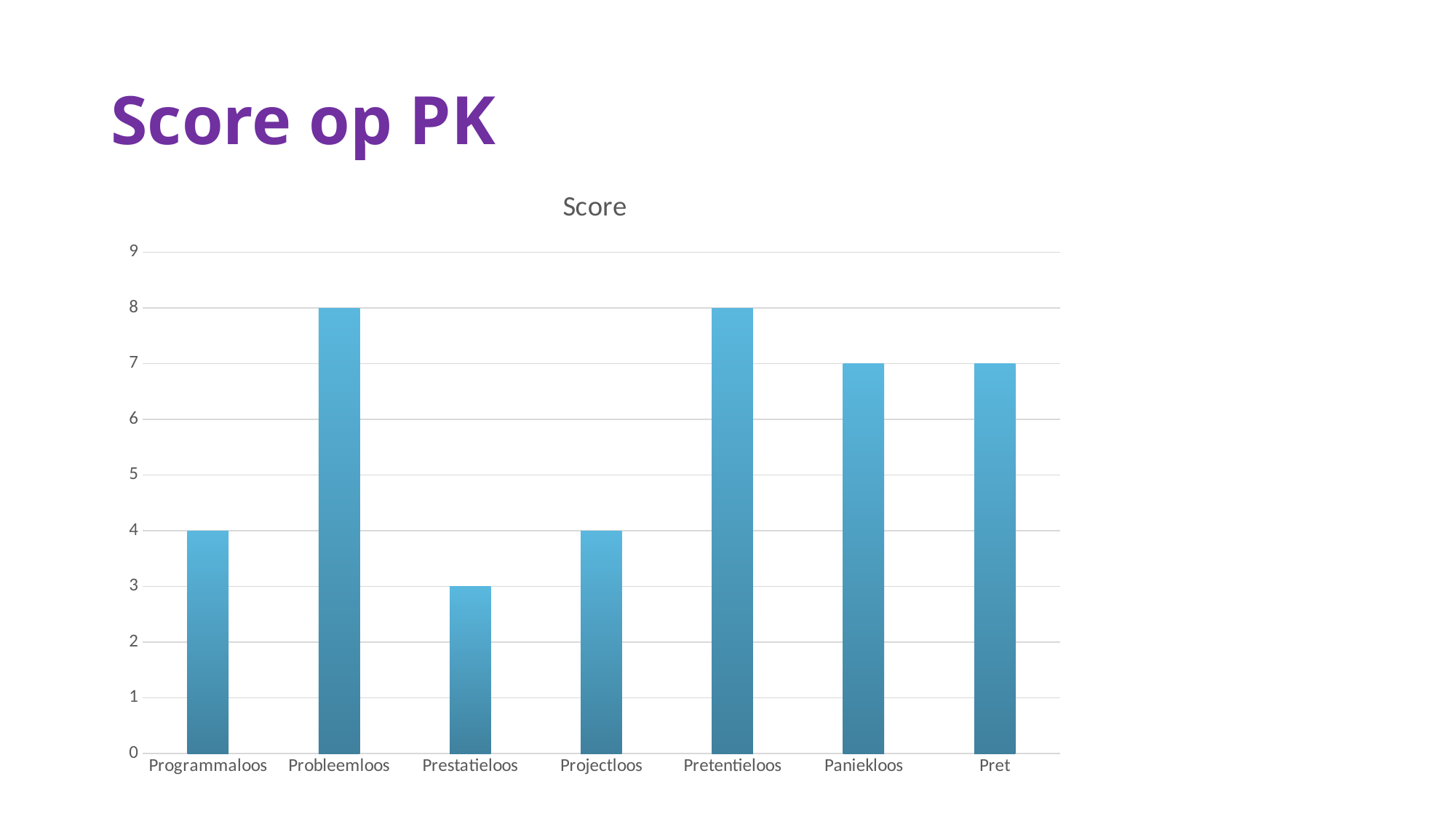
Is the score for Pretentieloos greater or less than 5? greater Which category has the lowest score? Prestatieloos What kind of chart is shown on the slide? bar chart Which has a higher score, Paniekloos or Projectloos? Paniekloos What is the difference between the scores for Probleemloos and Programmaloos? 4 What is the score for Paniekloos? 7 What is the difference between the scores for Pret and Prestatieloos? 4 What is the score for Programmaloos? 4 What is the title of the chart? Score What is the score for Pretentieloos? 8 How many categories are shown on the x axis? 7 What is the score for Prestatieloos? 3